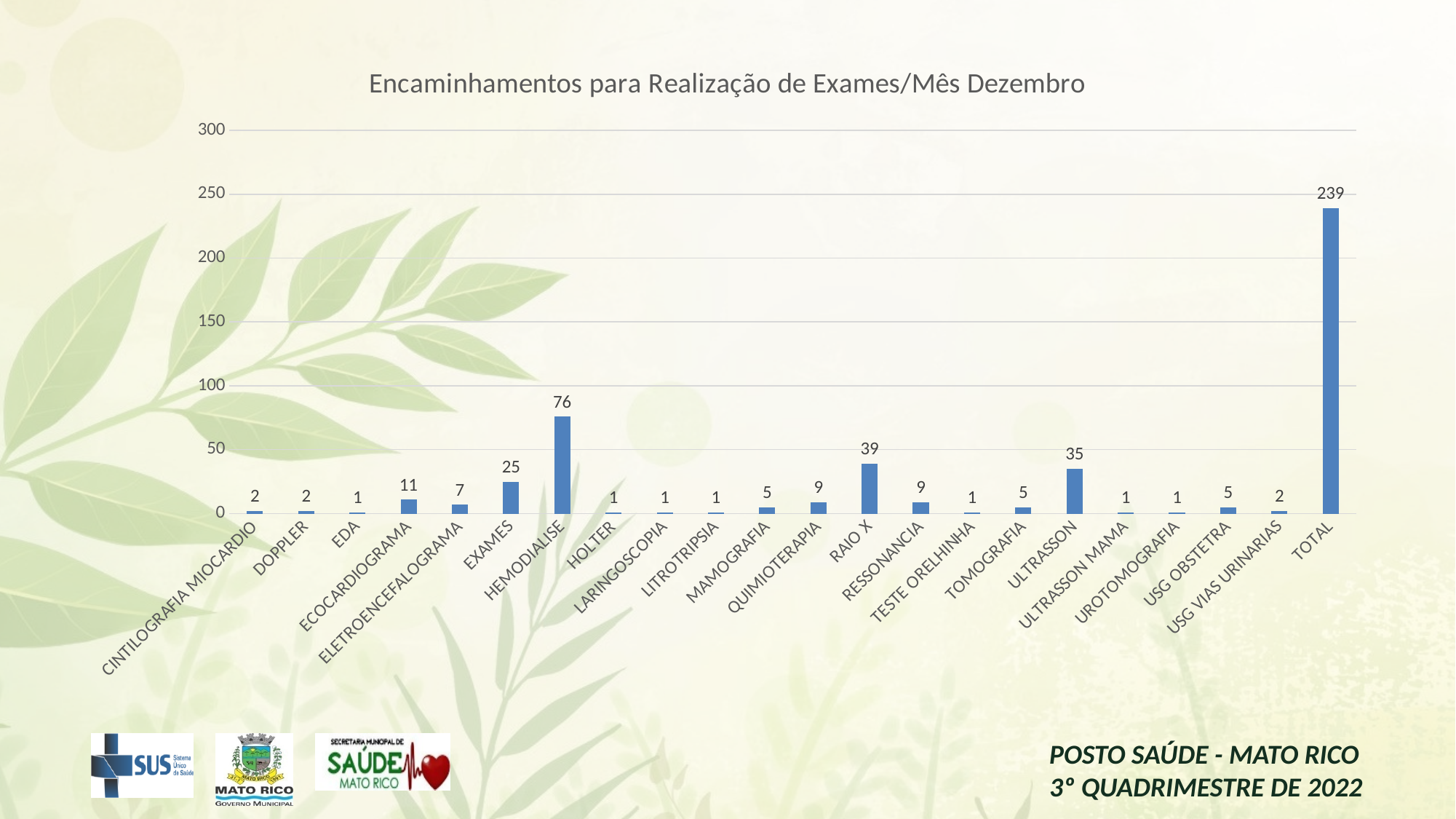
What is the value shown for the TOTAL bar? 239 Excluding the TOTAL bar, which category has the highest value? HEMODIALISE How many bars are shown in the chart, including the TOTAL bar? 22 Is the value for TOTAL greater or less than 200? greater What type of chart is shown on the slide? Bar chart Which is larger, the value for EXAMES or the value for ULTRASSON? ULTRASSON What is the lowest value shown on any bar in the chart? 1 What is the value for ULTRASSON? 35 What is the difference between the values for HEMODIALISE and RAIO X? 37 What is the value for RAIO X? 39 What is the value for HEMODIALISE? 76 What is the value for ECOCARDIOGRAMA? 11